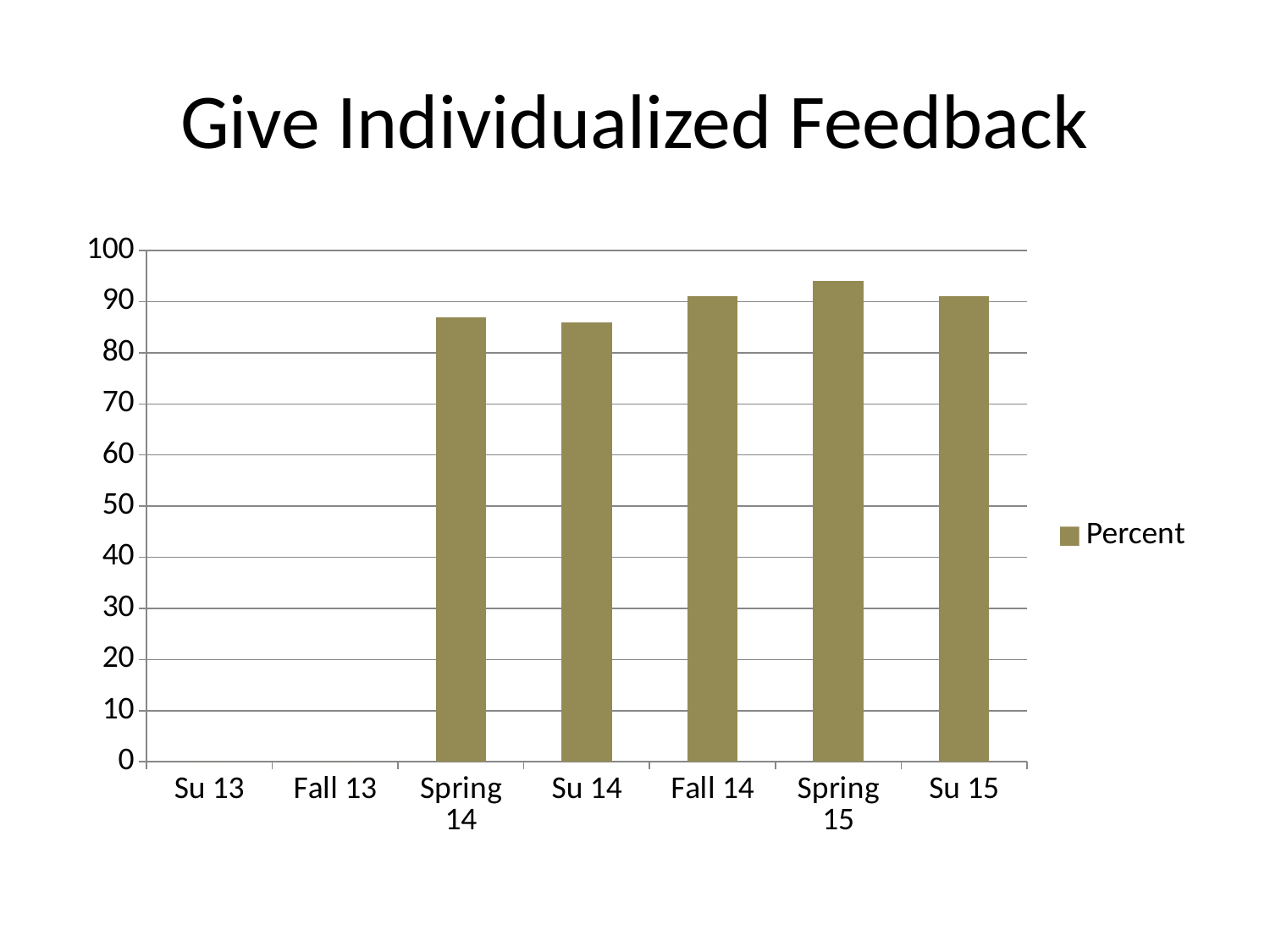
How many categories are shown on the x axis? 7 What is the name of the series shown in the legend? Percent What is the title of the slide? Give Individualized Feedback Is the value for Su 14 greater or less than 90? less Is the value for Spring 14 greater or less than 80? greater Which category has the highest bar? Spring 15 How many series does the legend list? 1 Which is larger, the value for Fall 14 or the value for Su 14? Fall 14 Which is larger, the value for Spring 15 or the value for Su 14? Spring 15 Is the value for Spring 15 greater or less than 90? greater What kind of chart is shown on the slide? bar chart